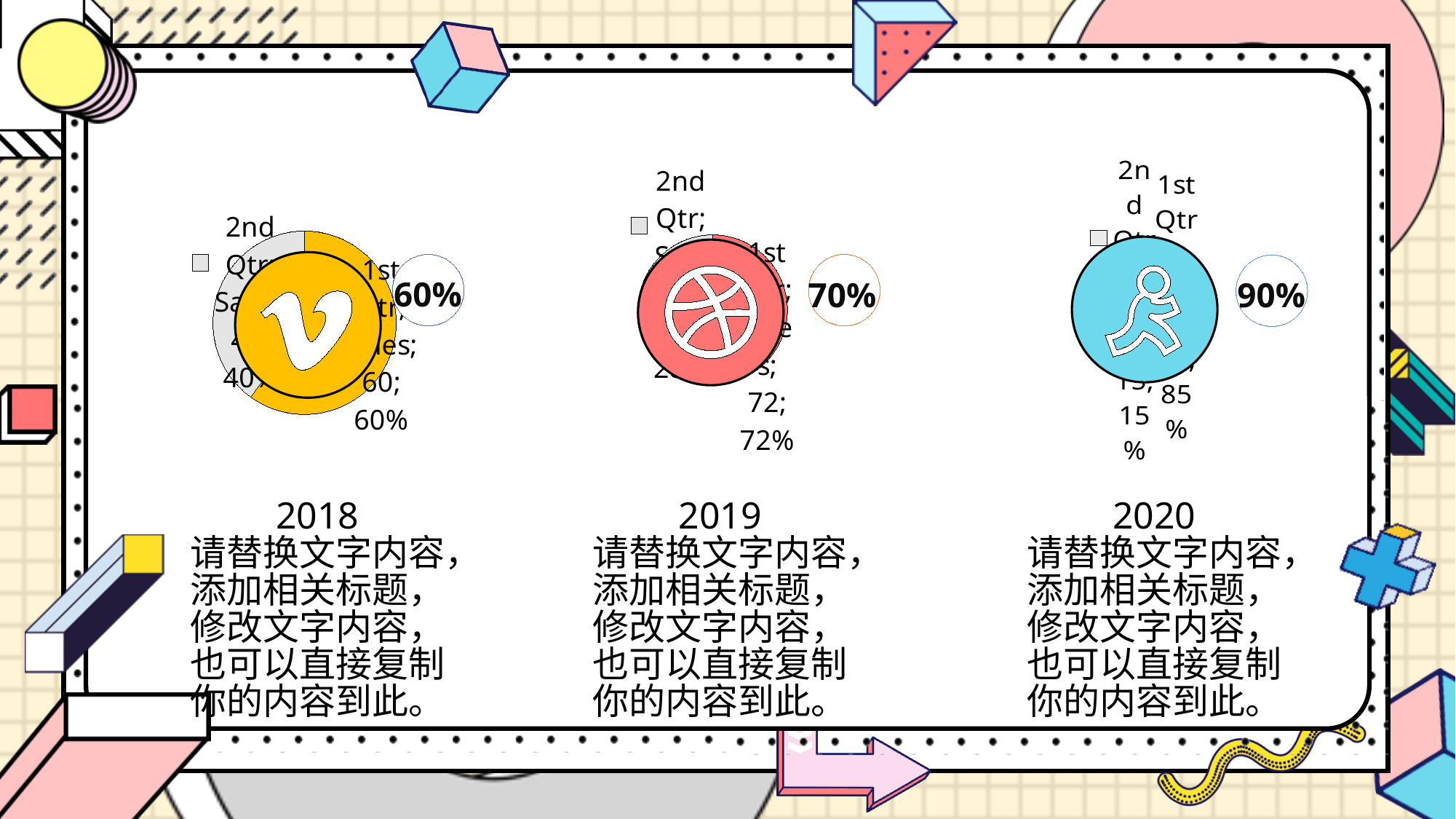
In the right chart (above 2020), what percentage is shown for 2nd Qtr? 15% In the middle chart (above 2019), what percentage is shown for 1st Qtr? 72% What series name appears in the data labels of the left chart (above 2018)? Sales In the left chart (above 2018), what percentage is shown for 1st Qtr? 60% How many charts are on the slide? 3 In the right chart (above 2020), what is the difference between the 1st Qtr and 2nd Qtr percentages? 70% In the left chart (above 2018), what is the value shown for 1st Qtr? 60 How many categories does the left chart (above 2018) show? 2 Which of the three charts shows the highest percentage for 1st Qtr? The right chart (2020) In the right chart (above 2020), which slice is larger, 1st Qtr or 2nd Qtr? 1st Qtr In the left chart (above 2018), which slice is larger, 1st Qtr or 2nd Qtr? 1st Qtr